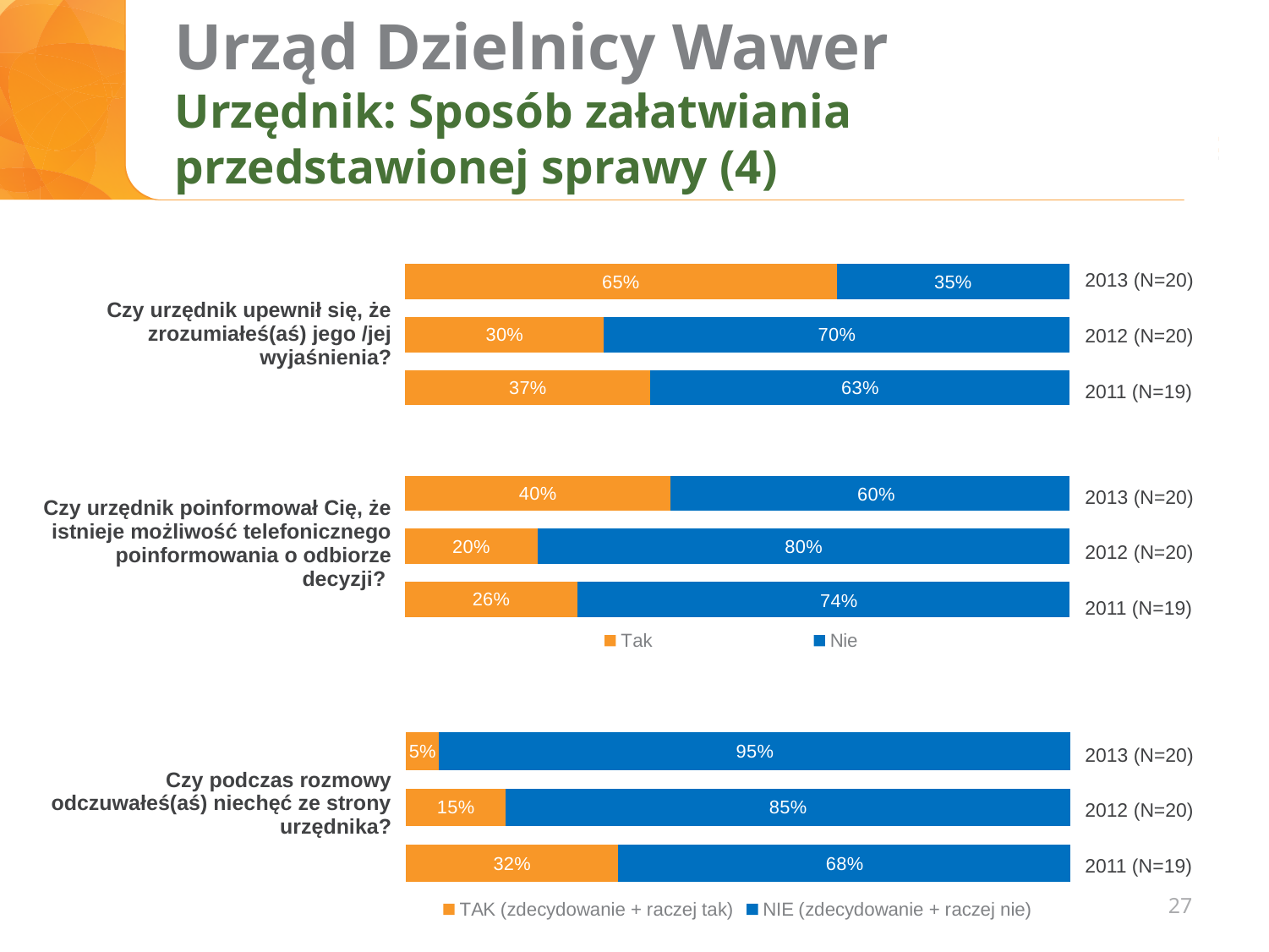
In the chart for 'Czy podczas rozmowy odczuwałeś(aś) niechęć ze strony urzędnika?', is the 'TAK' value larger for 2012 (N=20) or 2011 (N=19)? 2011 (N=19) In the chart for 'Czy podczas rozmowy odczuwałeś(aś) niechęć ze strony urzędnika?', which year has the highest 'TAK' value? 2011 (N=19) How many bars does the chart for 'Czy urzędnik upewnił się, że zrozumiałeś(aś) jego /jej wyjaśnienia?' contain? 3 In the chart for 'Czy urzędnik poinformował Cię, że istnieje możliwość telefonicznego poinformowania o odbiorze decyzji?', what is the 'Nie' value for 2012 (N=20)? 80% In the chart for 'Czy urzędnik poinformował Cię, że istnieje możliwość telefonicznego poinformowania o odbiorze decyzji?', which year has the lowest 'Tak' value? 2012 (N=20) In the chart for 'Czy urzędnik poinformował Cię, że istnieje możliwość telefonicznego poinformowania o odbiorze decyzji?', what is the difference between the 'Nie' and 'Tak' values for 2011 (N=19)? 48% What type of chart is used on this slide? Stacked bar chart In the chart for 'Czy urzędnik upewnił się, że zrozumiałeś(aś) jego /jej wyjaśnienia?', what is the 'Tak' value for 2013 (N=20)? 65% In the chart for 'Czy podczas rozmowy odczuwałeś(aś) niechęć ze strony urzędnika?', what is the 'NIE' value for 2013 (N=20)? 95% In the chart for 'Czy podczas rozmowy odczuwałeś(aś) niechęć ze strony urzędnika?', what is the total of the 2012 (N=20) stacked bar? 100% In the chart for 'Czy urzędnik upewnił się, że zrozumiałeś(aś) jego /jej wyjaśnienia?', which year has the highest 'Tak' value? 2013 (N=20) In the chart for 'Czy urzędnik upewnił się, że zrozumiałeś(aś) jego /jej wyjaśnienia?', what is the 'Nie' value for 2012 (N=20)? 70%